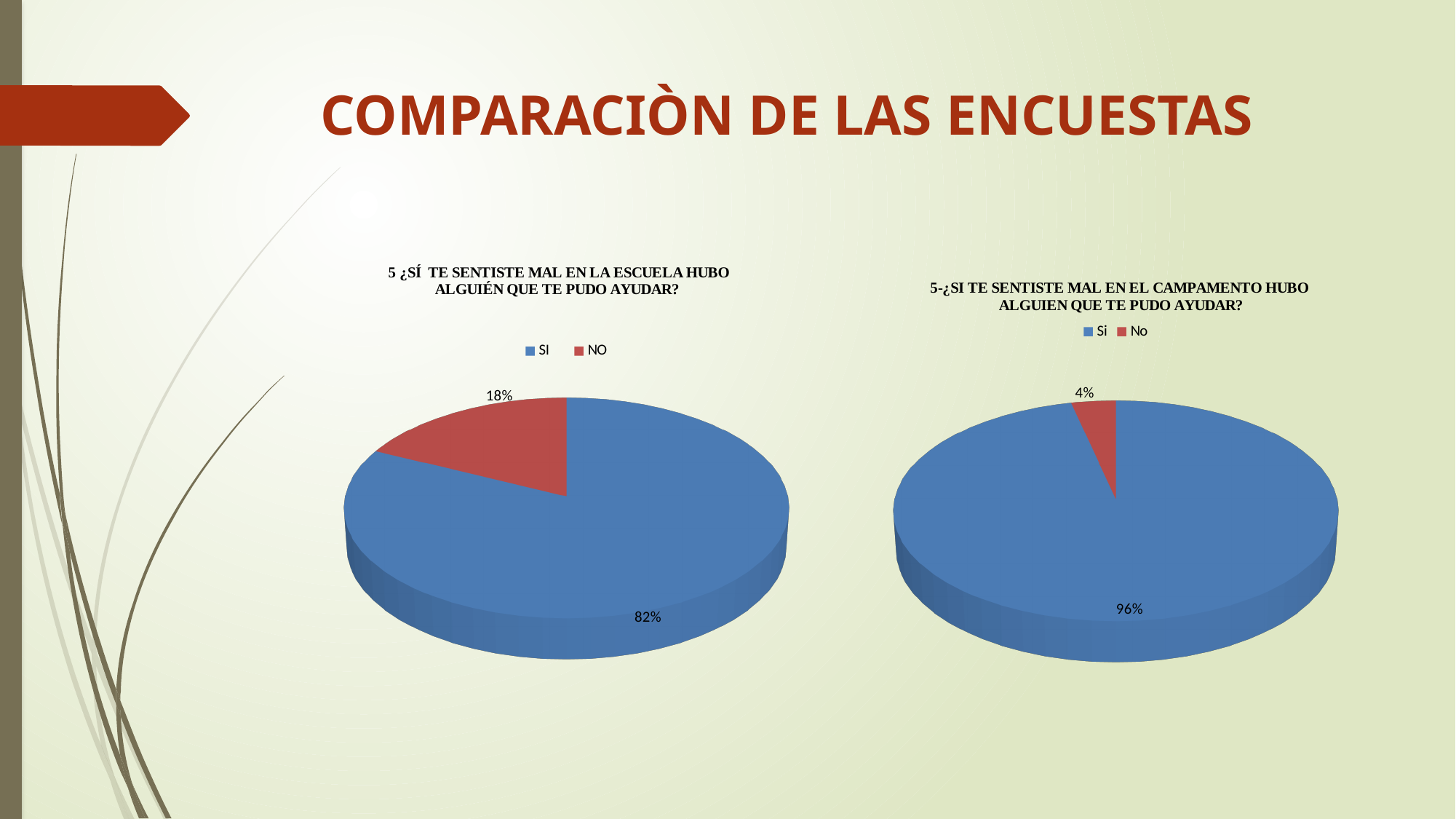
What type of chart is used on this slide? Pie chart In the right pie chart (camp), what percentage answered Si? 96% In the left pie chart (school), what percentage answered SI? 82% How many slices does the right pie chart (camp) have? 2 In the left pie chart (school), which answer has the largest share? SI In the left pie chart (school), what percentage answered NO? 18% In the right pie chart (camp), which answer has the smallest share? No How many entries does the legend of the left pie chart (school) list? 2 In the right pie chart (camp), what percentage answered No? 4% In the left pie chart (school), what is the difference between the SI and NO shares? 64% Is the NO share larger in the left pie chart (school) or the right pie chart (camp)? Left (school) In the right pie chart (camp), what colour is the Si slice? Blue